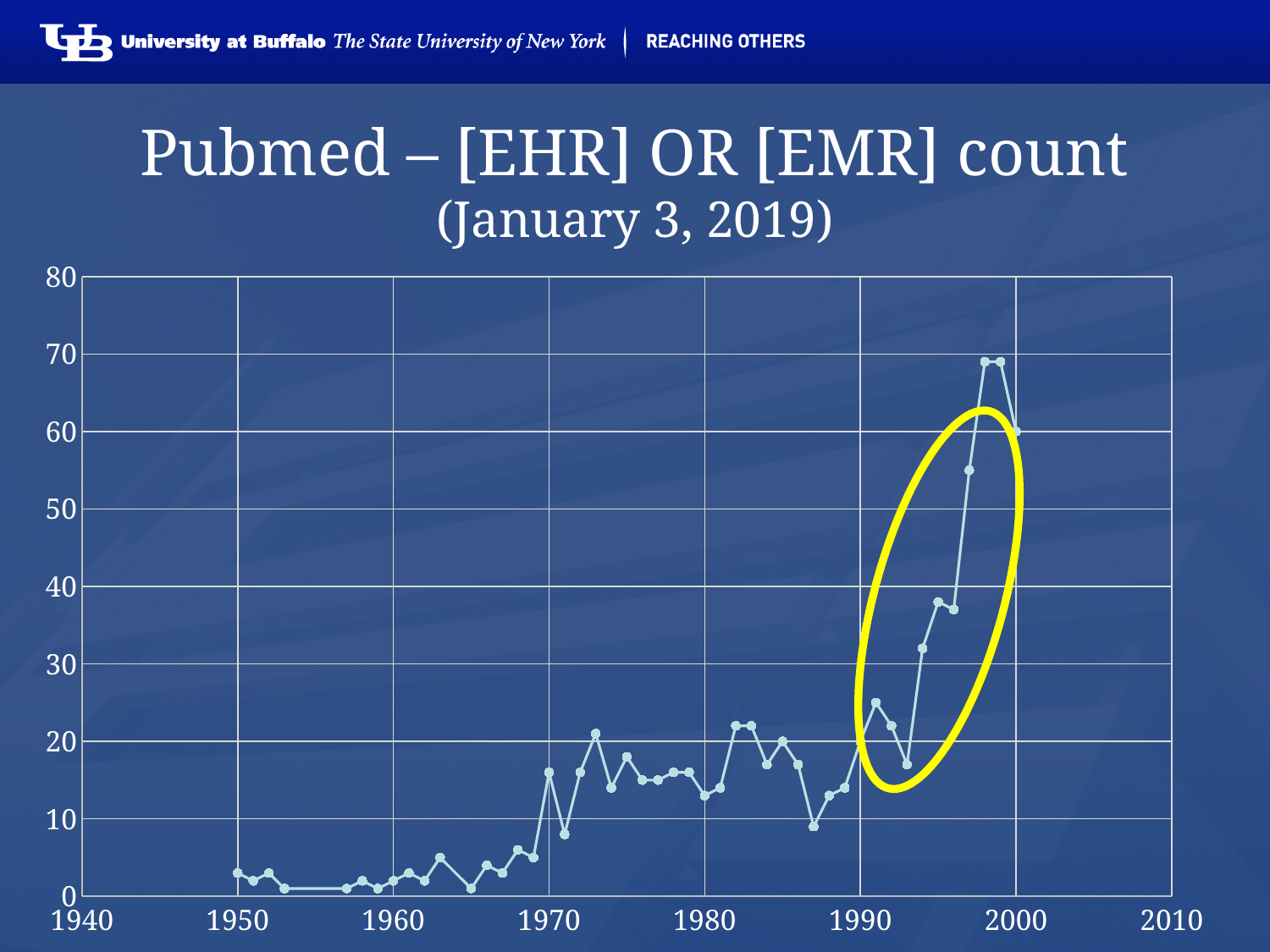
Overall, do the values rise or fall from 1950 to 2000? rise What kind of chart is shown on the slide? line chart Is the value for 1997 greater or less than 50? greater Is the value for 1950 greater or less than 10? less Is the value for 1995 greater or less than 30? greater Which decade is highlighted by the yellow ellipse on the chart? the 1990s What is the title of the chart? Pubmed – [EHR] OR [EMR] count (January 3, 2019)